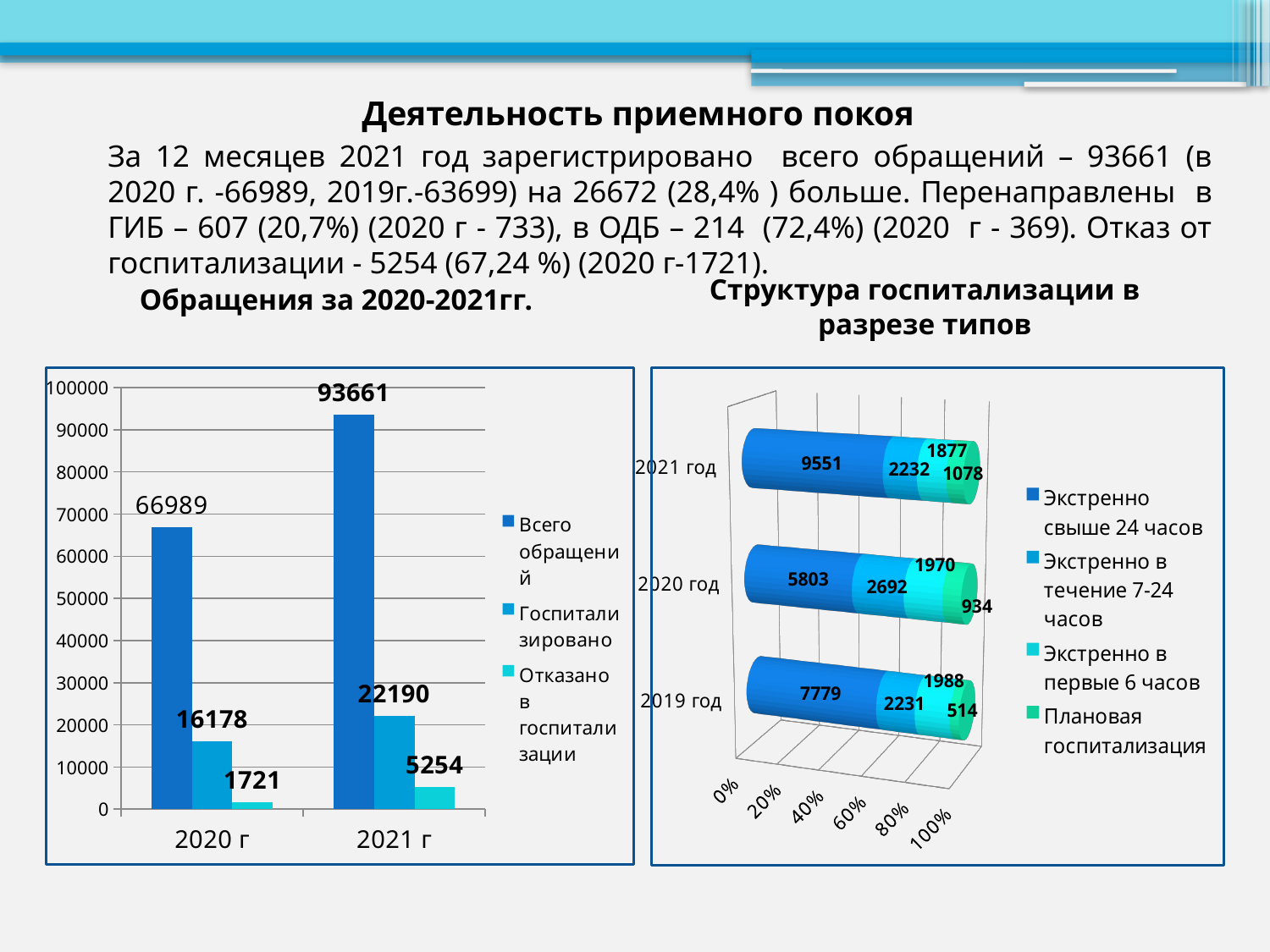
In the chart 'Обращения за 2020-2021гг.', what is the value of 'Отказано в госпитализации' for 2020 г? 1721 In the chart 'Структура госпитализации в разрезе типов', how many years are shown? 3 What kind of chart is 'Обращения за 2020-2021гг.'? Bar chart In the chart 'Структура госпитализации в разрезе типов', what is the total of all four segments for 2020 год? 11399 In the chart 'Структура госпитализации в разрезе типов', how many series does the legend list? 4 In the chart 'Обращения за 2020-2021гг.', which year has the higher value for 'Отказано в госпитализации'? 2021 г In the chart 'Структура госпитализации в разрезе типов', which year has the lowest value for 'Экстренно свыше 24 часов'? 2020 год In the chart 'Структура госпитализации в разрезе типов', what is the value of 'Экстренно свыше 24 часов' for 2021 год? 9551 In the chart 'Обращения за 2020-2021гг.', what is the difference between 'Госпитализировано' in 2021 г and in 2020 г? 6012 In the chart 'Обращения за 2020-2021гг.', what is the value of 'Всего обращений' for 2021 г? 93661 In the chart 'Обращения за 2020-2021гг.', how many series does the legend list? 3 In the chart 'Структура госпитализации в разрезе типов', what is the value of 'Плановая госпитализация' for 2019 год? 514